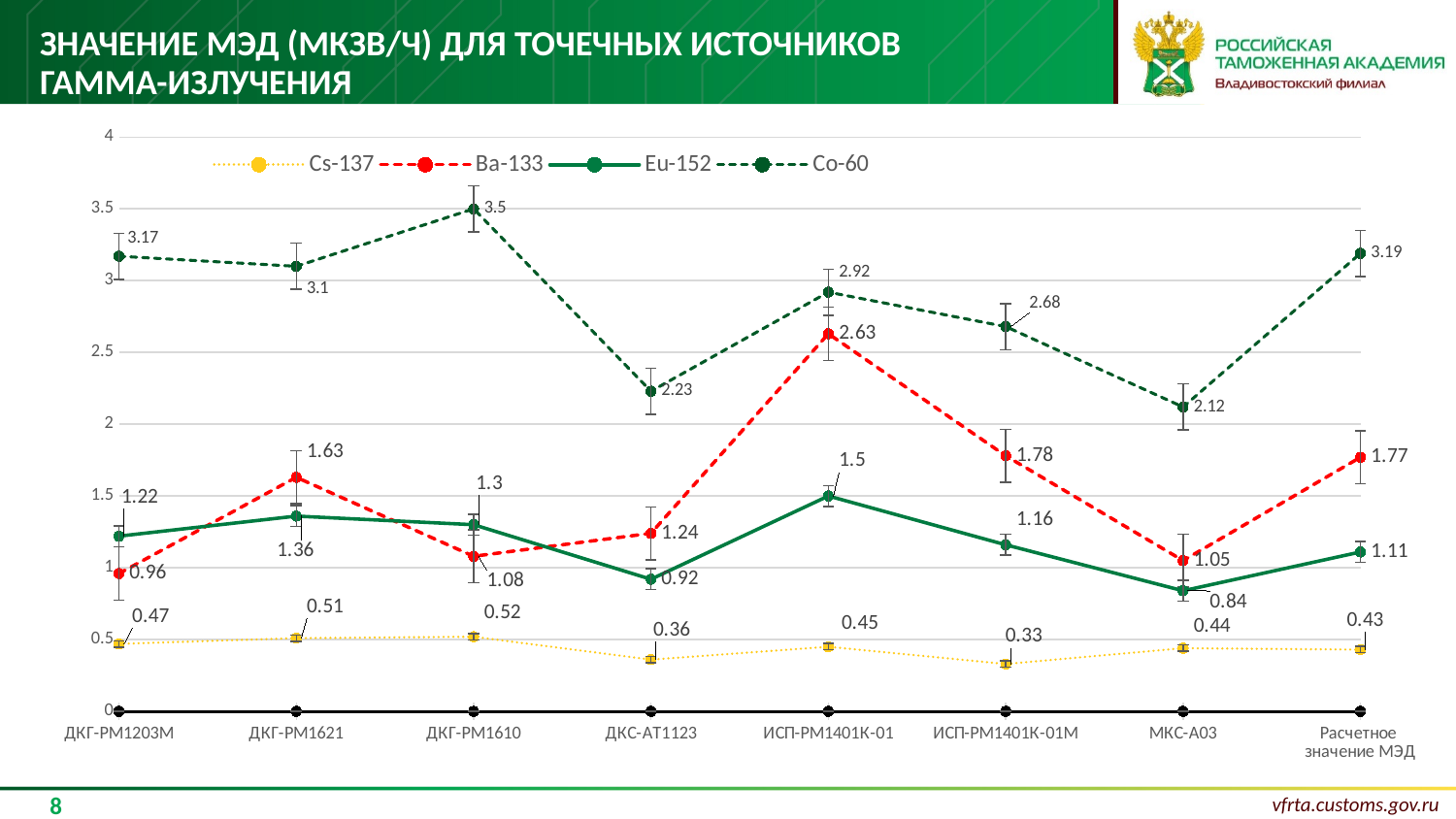
What type of chart is shown on the slide? line chart Which series is drawn with a dotted yellow line? Cs-137 How many categories are shown along the x axis? 8 At which category does Co-60 reach its highest value? ДКГ-РМ1610 Which is larger at ДКГ-РМ1621: the Ba-133 value or the Eu-152 value? Ba-133 What is the difference between the Co-60 and Ba-133 values at Расчетное значение МЭД? 1.42 What is the value for Cs-137 at ИСП-РМ1401К-01М? 0.33 How many series does the legend list? 4 What is the value for Eu-152 at МКС-А03? 0.84 What is the value for Ba-133 at ИСП-РМ1401К-01? 2.63 What is the value for Co-60 at ДКГ-РМ1610? 3.5 At which category does Cs-137 have its lowest value? ИСП-РМ1401К-01М